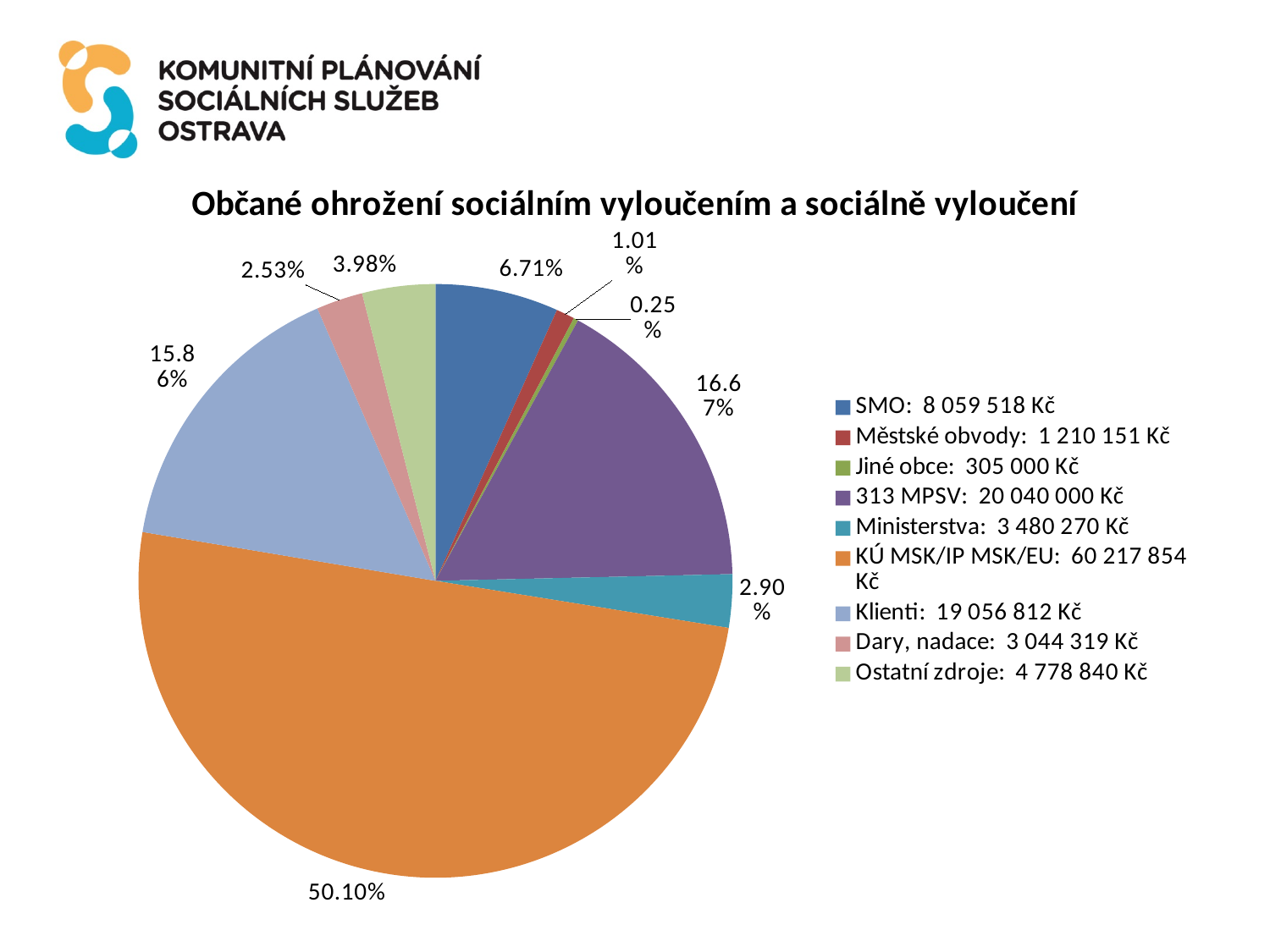
What share of the pie does 313 MPSV represent? 16.67% Which category has the smallest slice of the pie? Jiné obce What is the title of the chart? Občané ohrožení sociálním vyloučením a sociálně vyloučení What kind of chart is shown on the slide? pie chart What share of the pie does SMO represent? 6.71% What amount in Kč is listed in the legend for Ministerstva? 3 480 270 Kč Which category has the largest slice of the pie? KÚ MSK/IP MSK/EU How many slices does the pie chart have? 9 What amount in Kč is listed in the legend for Dary, nadace? 3 044 319 Kč Which slice is larger, Klienti or Ostatní zdroje? Klienti What share of the pie does KÚ MSK/IP MSK/EU represent? 50.10%